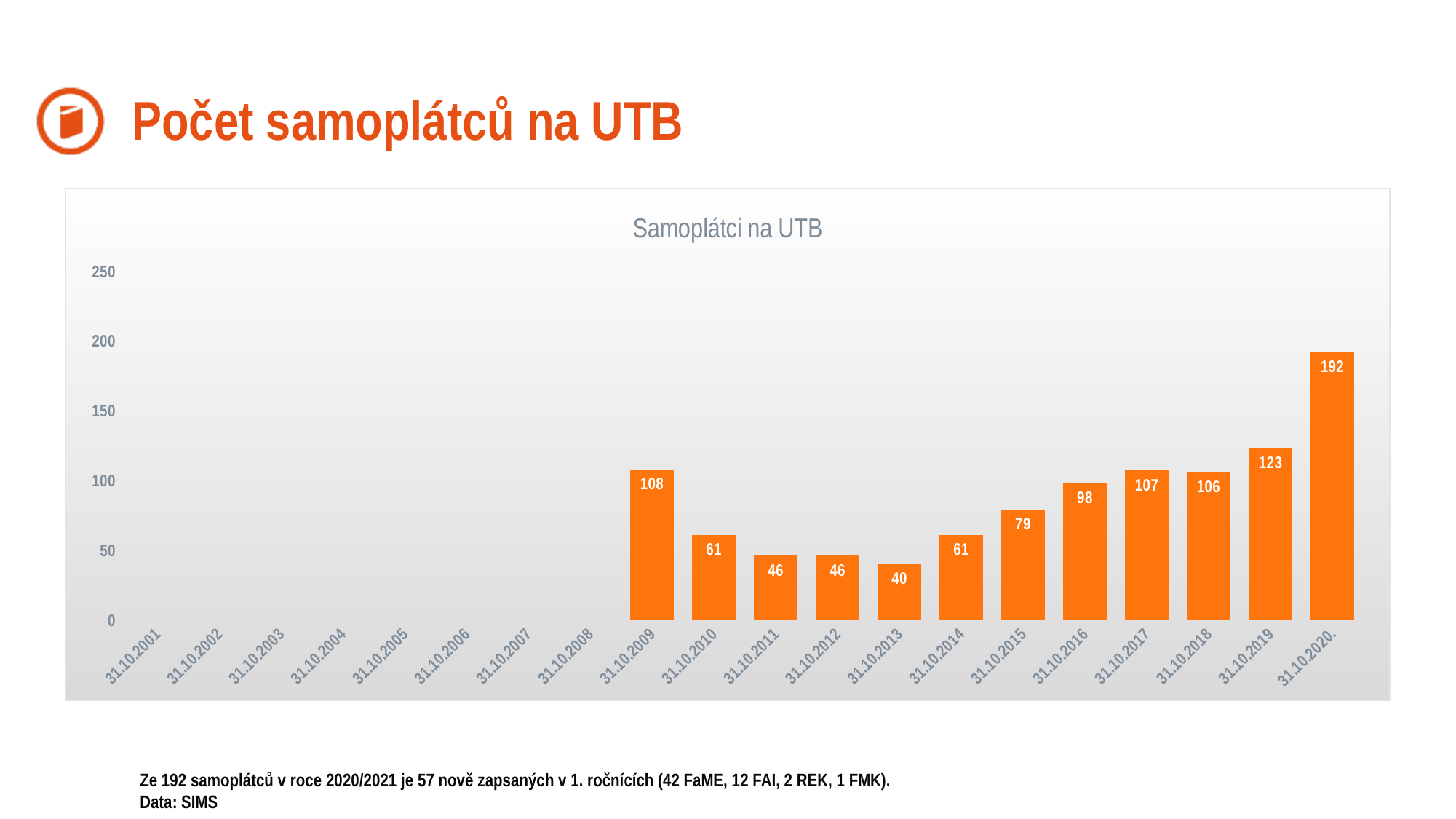
Is the value for 31.10.2020. greater or less than 150? greater Do the values rise or fall from 31.10.2013 to 31.10.2020.? rise How many date categories are shown on the x axis? 20 What kind of chart is this? bar chart Among the dates with a bar shown, which has the lowest value? 31.10.2013 Which date has the highest value? 31.10.2020. Which is larger, the value for 31.10.2017 or the value for 31.10.2018? 31.10.2017 What is the value for 31.10.2019? 123 What is the difference between the values for 31.10.2020. and 31.10.2019? 69 What is the value for 31.10.2013? 40 What is the title of the chart? Samoplátci na UTB What is the value for 31.10.2009? 108